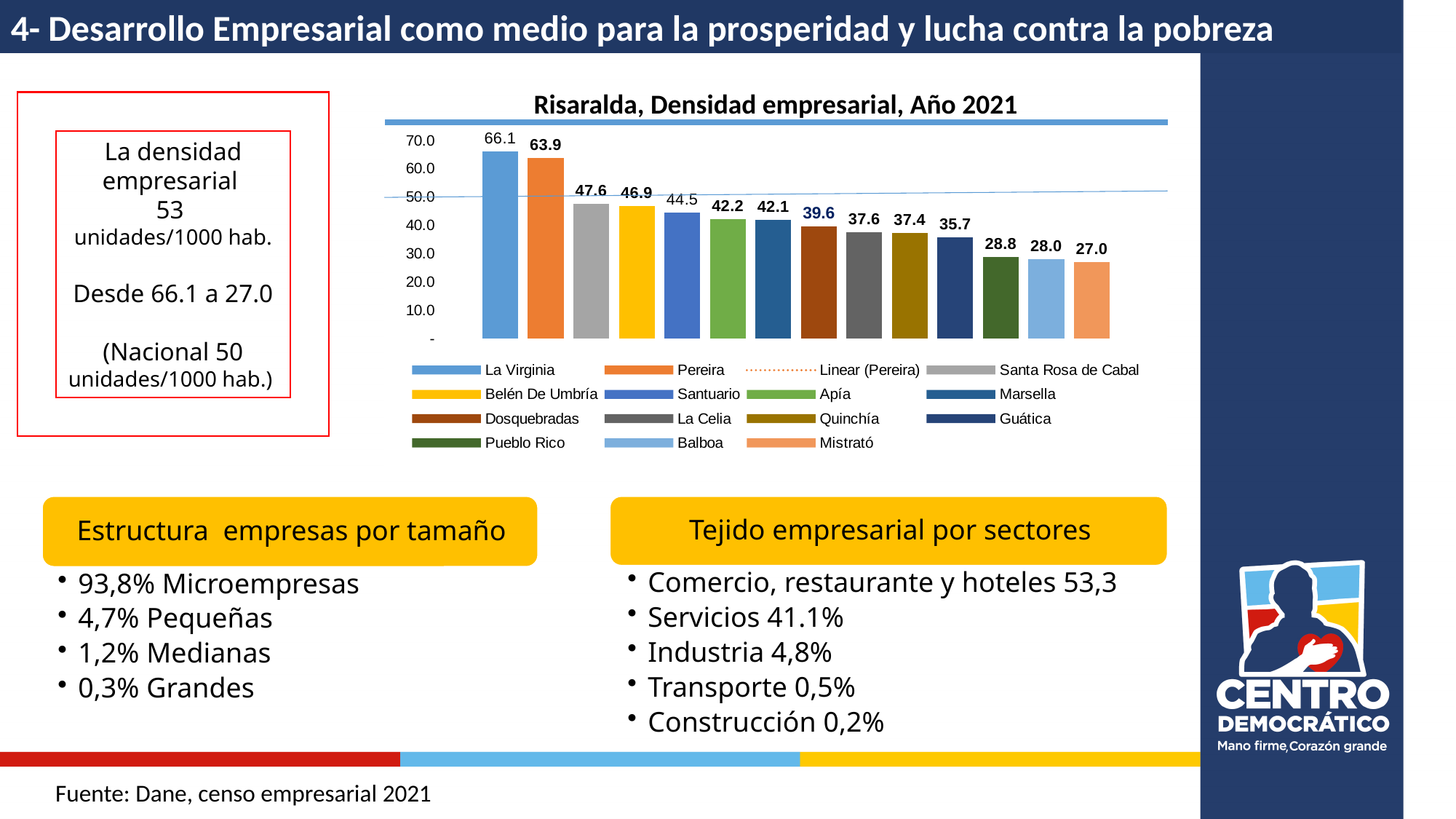
What is the value for Dosquebradas in the chart? 39.6 How many bars are plotted in the chart? 14 What is the title of the chart? Risaralda, Densidad empresarial, Año 2021 What is the difference between the values for Santa Rosa de Cabal and Mistrató? 20.6 Which municipality has the highest value in the chart? La Virginia Which municipality has the lowest value in the chart? Mistrató What is the difference between the values for La Virginia and Pereira? 2.2 Which is larger, the value for Guática or the value for Pueblo Rico? Guática What is the value for La Virginia in the Risaralda, Densidad empresarial, Año 2021 chart? 66.1 What is the value for Mistrató in the chart? 27.0 What kind of chart is shown on the slide? bar chart Is the value for Santuario greater or less than 50.0? less